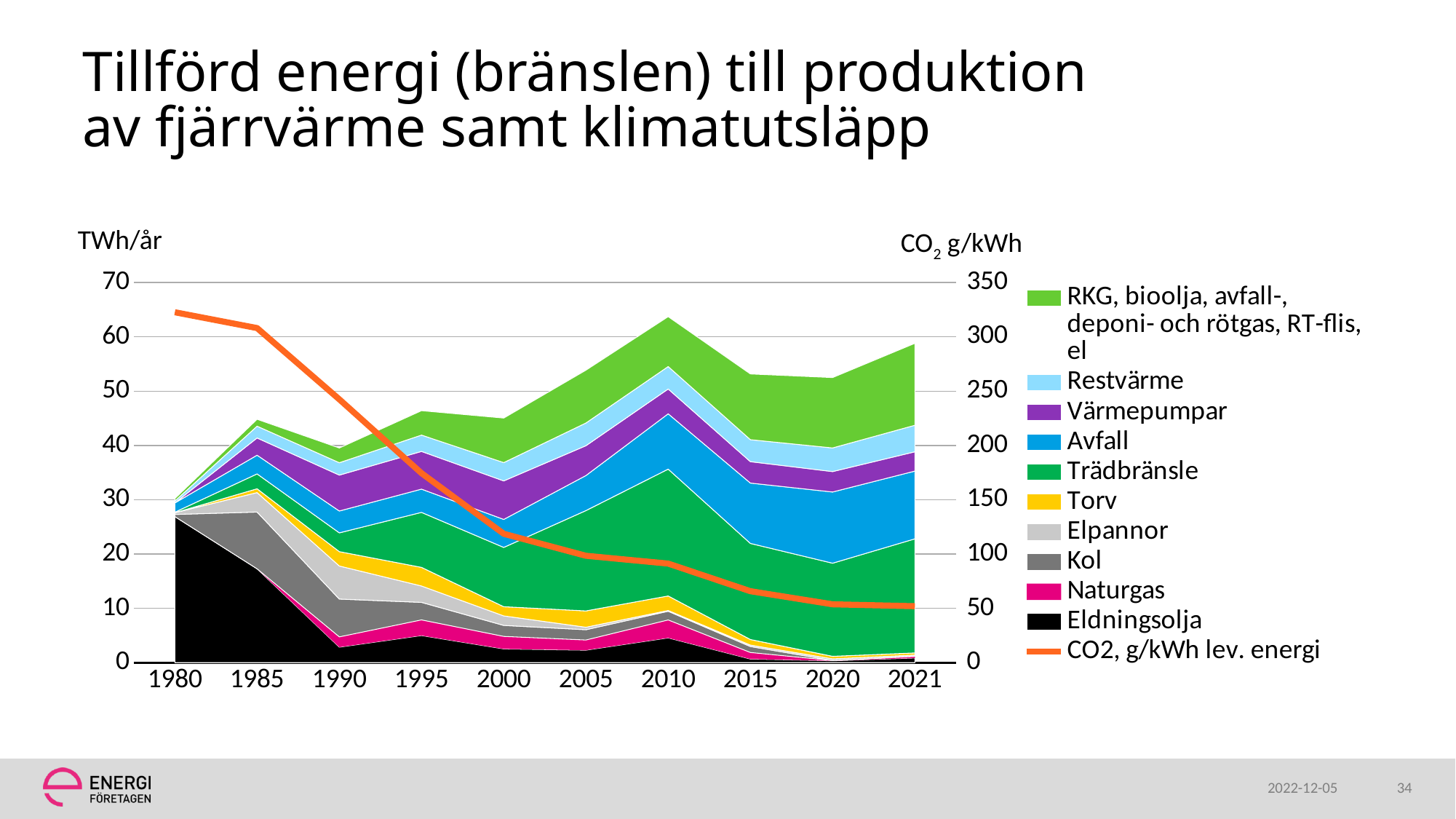
In which year is the total stacked energy (TWh/år) lowest? 1980 Which series is shown in black at the bottom of the stack? Eldningsolja Is the value of the CO2, g/kWh lev. energi line in 1995 greater or less than 200? less How many entries does the legend list? 11 Is the total stacked energy in 1980 greater or less than 40 TWh/år? less What unit is shown on the right-hand axis? CO2 g/kWh Does the CO2, g/kWh lev. energi line rise or fall from 1980 to 2021? Fall How many years are shown along the x axis? 10 Is the value of the CO2, g/kWh lev. energi line in 1980 greater or less than 300? greater What kind of chart is shown on the slide? Stacked area chart with a line